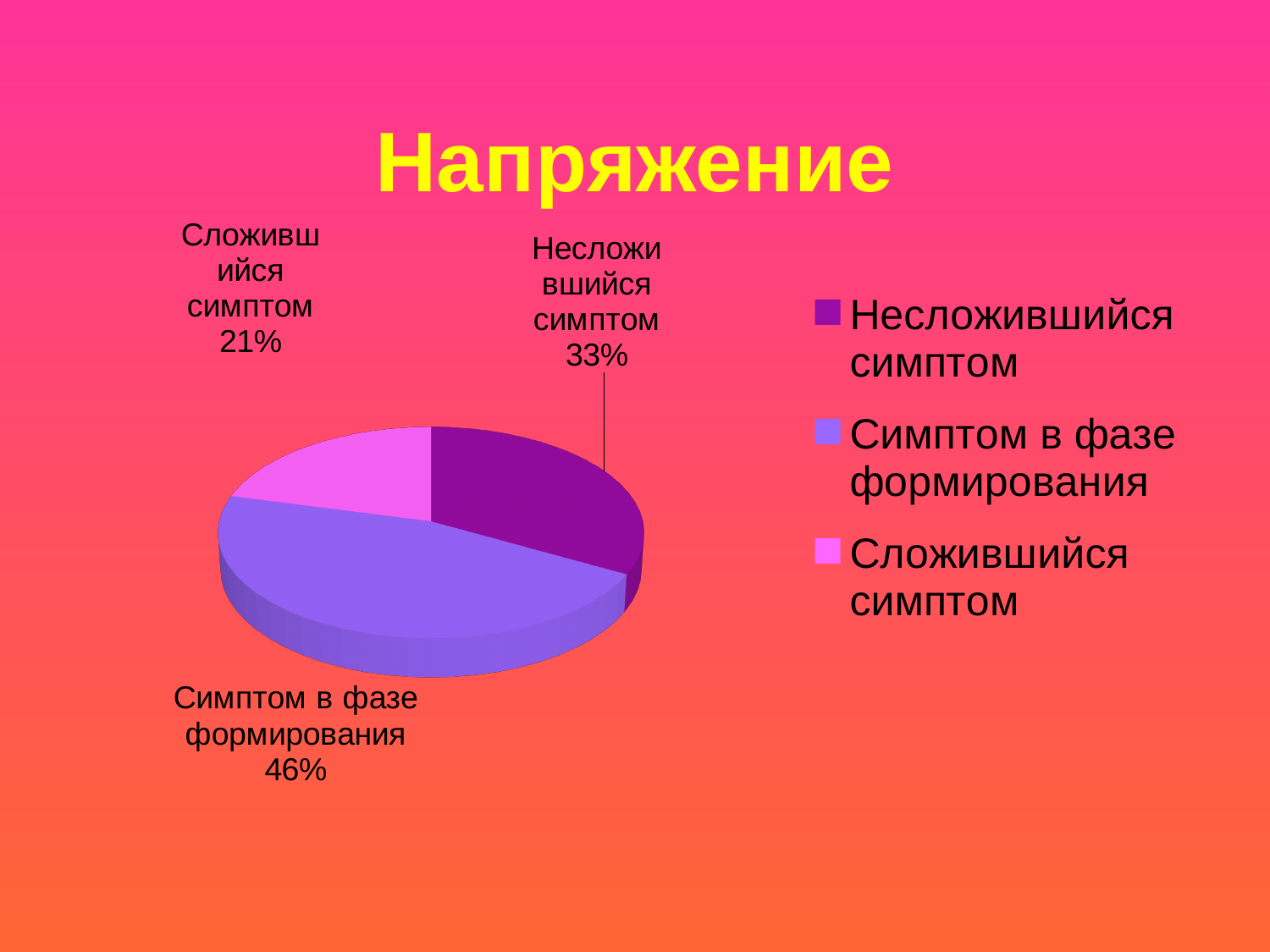
What share of the pie does "Сложившийся симптом" have? 21% What is the difference in percentage points between "Несложившийся симптом" and "Сложившийся симптом"? 12 What is the title of the slide with the pie chart? Напряжение What share of the pie does "Несложившийся симптом" have? 33% What is the difference in percentage points between "Симптом в фазе формирования" and "Сложившийся симптом"? 25 What share of the pie does "Симптом в фазе формирования" have? 46% Which is larger: the share for "Несложившийся симптом" or the share for "Сложившийся симптом"? Несложившийся симптом What kind of chart is shown on the slide? pie chart How many slices does the pie chart have? 3 Which category has the largest slice of the pie? Симптом в фазе формирования Which category has the smallest slice of the pie? Сложившийся симптом How many entries does the legend list? 3